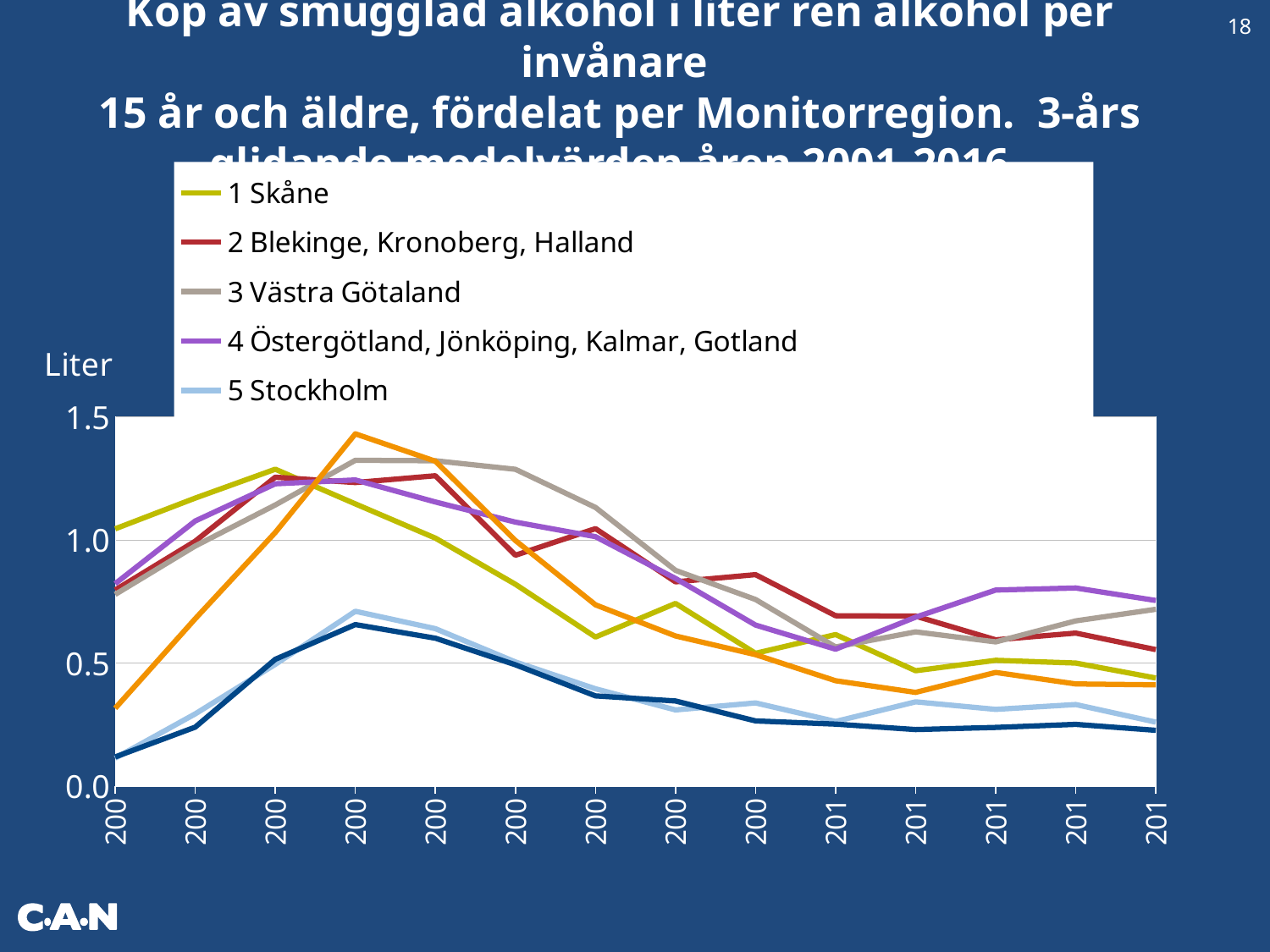
Is the value for 1 Skåne at the first point on the horizontal axis greater or less than 1.0? greater What kind of chart is shown on the slide? line chart At the first point on the horizontal axis, which is higher: 1 Skåne or 5 Stockholm? 1 Skåne What is the title of the vertical axis? Liter Is the peak value of 5 Stockholm greater or less than 1.0? less Is the value for 4 Östergötland, Jönköping, Kalmar, Gotland at the last point on the horizontal axis greater or less than 0.5? greater What is the highest value labelled on the vertical axis? 1.5 How many tick marks are there along the horizontal axis? 14 Comparing the first and last points on the horizontal axis, does the value for 1 Skåne rise or fall? fall At the last point on the horizontal axis, which is higher: 4 Östergötland, Jönköping, Kalmar, Gotland or 1 Skåne? 4 Östergötland, Jönköping, Kalmar, Gotland